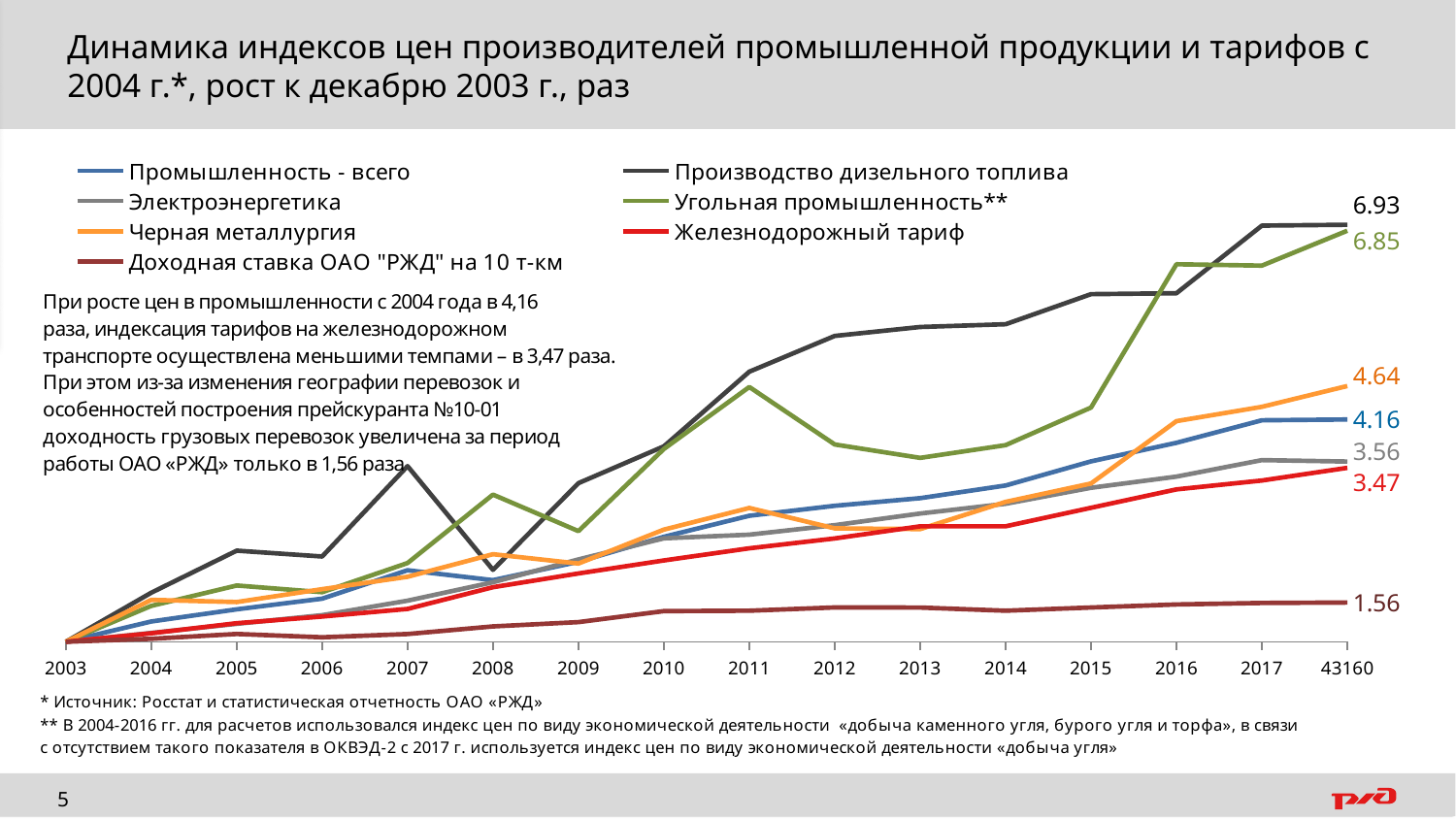
What is the final labelled value for the series "Производство дизельного топлива"? 6.93 Which series has the highest value at the end of the chart? Производство дизельного топлива How many series does the legend list? 7 Which series ends higher: "Электроэнергетика" or "Черная металлургия"? Черная металлургия What is the final labelled value for the series "Угольная промышленность**"? 6.85 What is the final labelled value for the series "Железнодорожный тариф"? 3.47 What is the final labelled value for the series "Черная металлургия"? 4.64 What is the difference between the final values of "Промышленность - всего" (4.16) and "Железнодорожный тариф" (3.47)? 0.69 What type of chart is shown on the slide? line chart Does the series "Железнодорожный тариф" generally rise or fall from 2003 to the end of the chart? rise What is the final labelled value for the series "Доходная ставка ОАО "РЖД" на 10 т-км"? 1.56 Which series has the lowest value at the end of the chart? Доходная ставка ОАО "РЖД" на 10 т-км